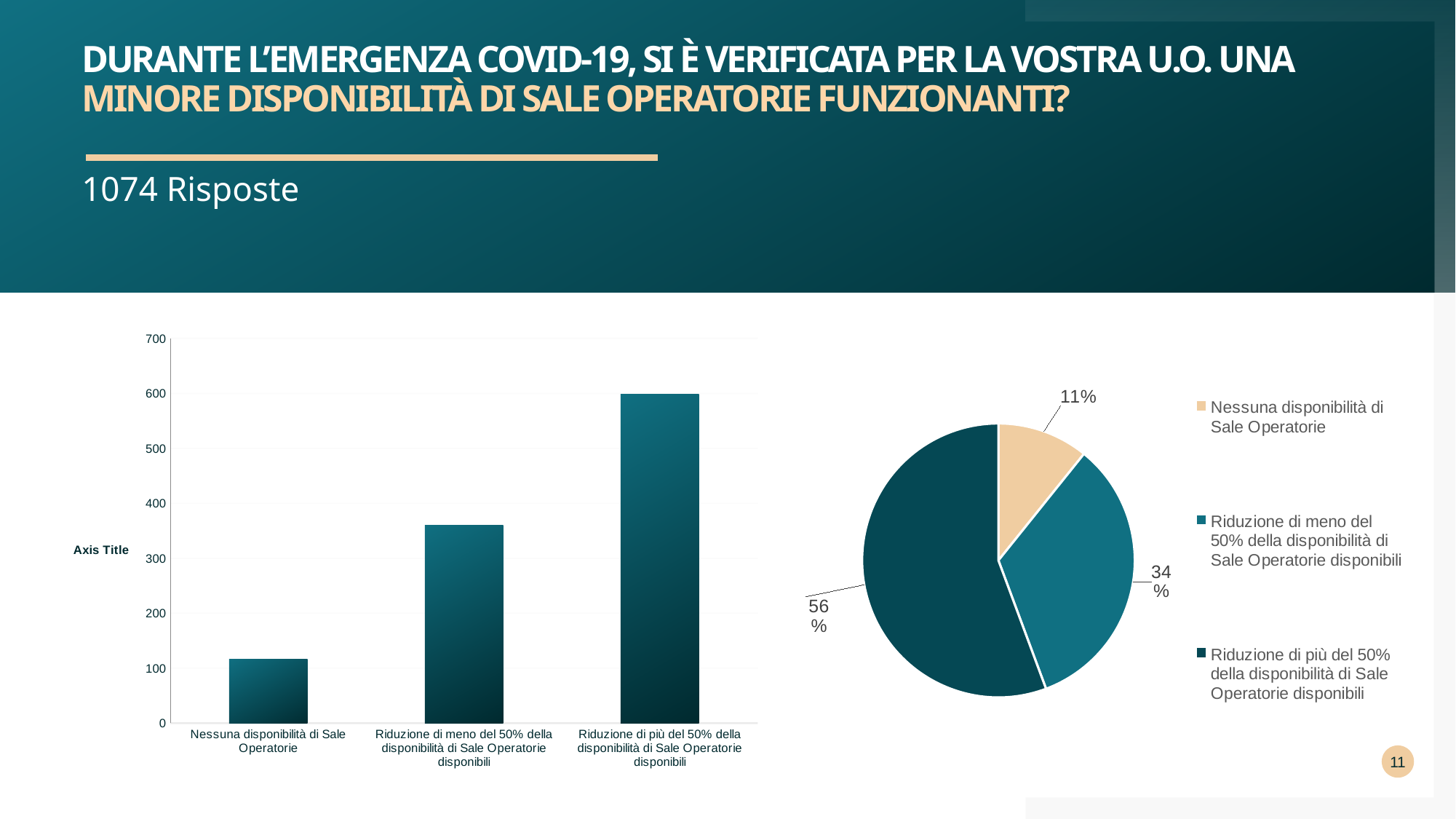
In the pie chart on the right, which slice is the smallest? Nessuna disponibilità di Sale Operatorie In the pie chart on the right, what share is shown for Nessuna disponibilità di Sale Operatorie? 11% In the bar chart on the left, is the value for Riduzione di più del 50% della disponibilità di Sale Operatorie disponibili greater or less than 500? greater What kind of chart is on the left side of the slide? bar chart How many entries does the legend of the pie chart on the right list? 3 What kind of chart is on the right side of the slide? pie chart In the pie chart on the right, what share is shown for Riduzione di più del 50% della disponibilità di Sale Operatorie disponibili? 56% In the bar chart on the left, which category has the lowest bar? Nessuna disponibilità di Sale Operatorie In the bar chart on the left, which category has the highest bar? Riduzione di più del 50% della disponibilità di Sale Operatorie disponibili In the bar chart on the left, is the value for Nessuna disponibilità di Sale Operatorie greater or less than 200? less In the bar chart on the left, how many categories are shown? 3 In the bar chart on the left, do the values rise or fall from left to right along the x axis? rise